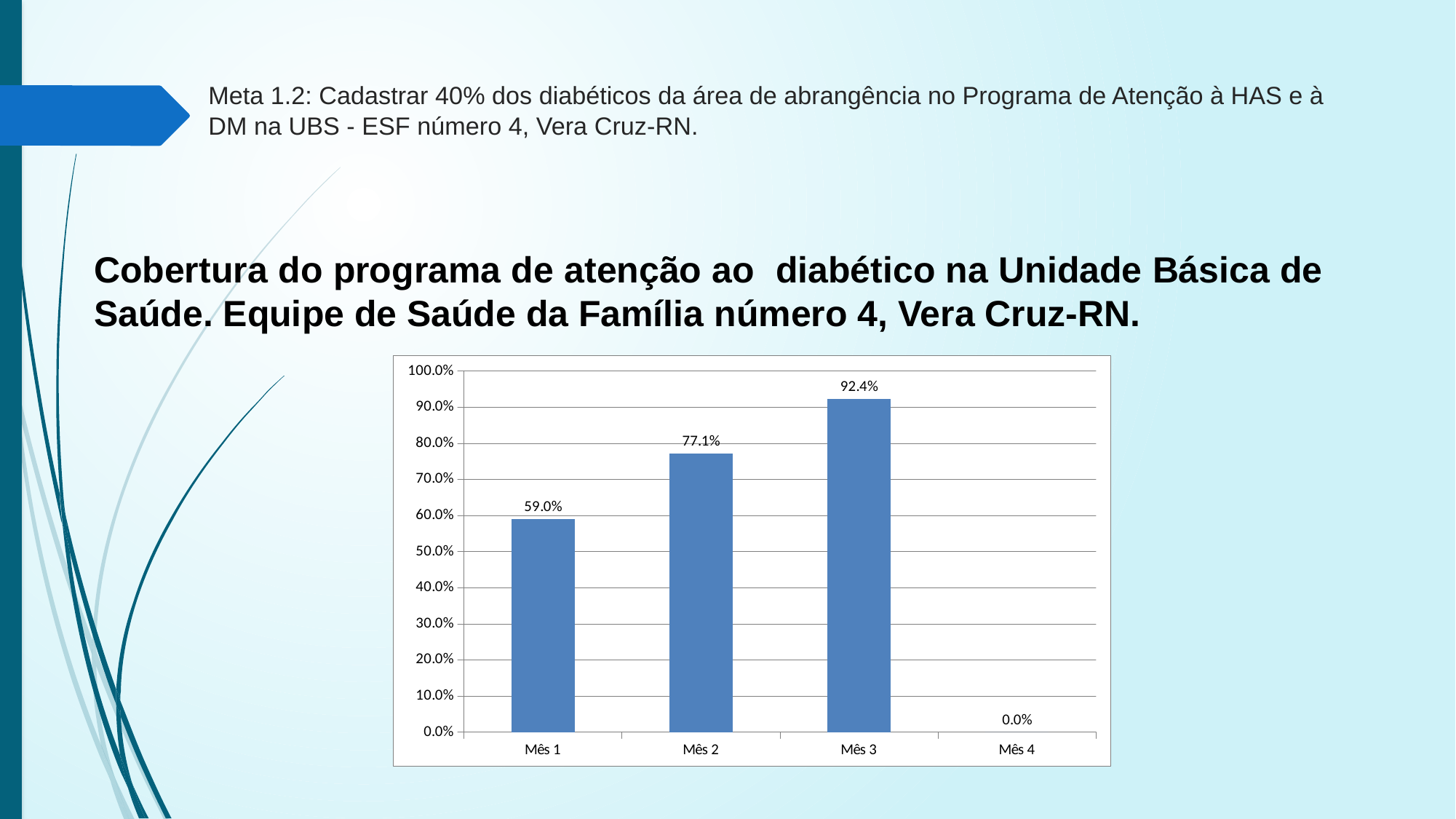
What is the value for Mês 4? 0.0% Which is larger, the value for Mês 2 or the value for Mês 3? Mês 3 What is the difference between the values for Mês 3 and Mês 1? 33.4% How many categories are shown on the x axis? 4 Which month has the lowest value? Mês 4 Which month has the highest value? Mês 3 What is the value for Mês 1? 59.0% What kind of chart is shown on the slide? Bar chart Do the values rise or fall from Mês 1 to Mês 3? Rise What is the value for Mês 3? 92.4% What is the value for Mês 2? 77.1% What is the difference between the values for Mês 2 and Mês 1? 18.1%